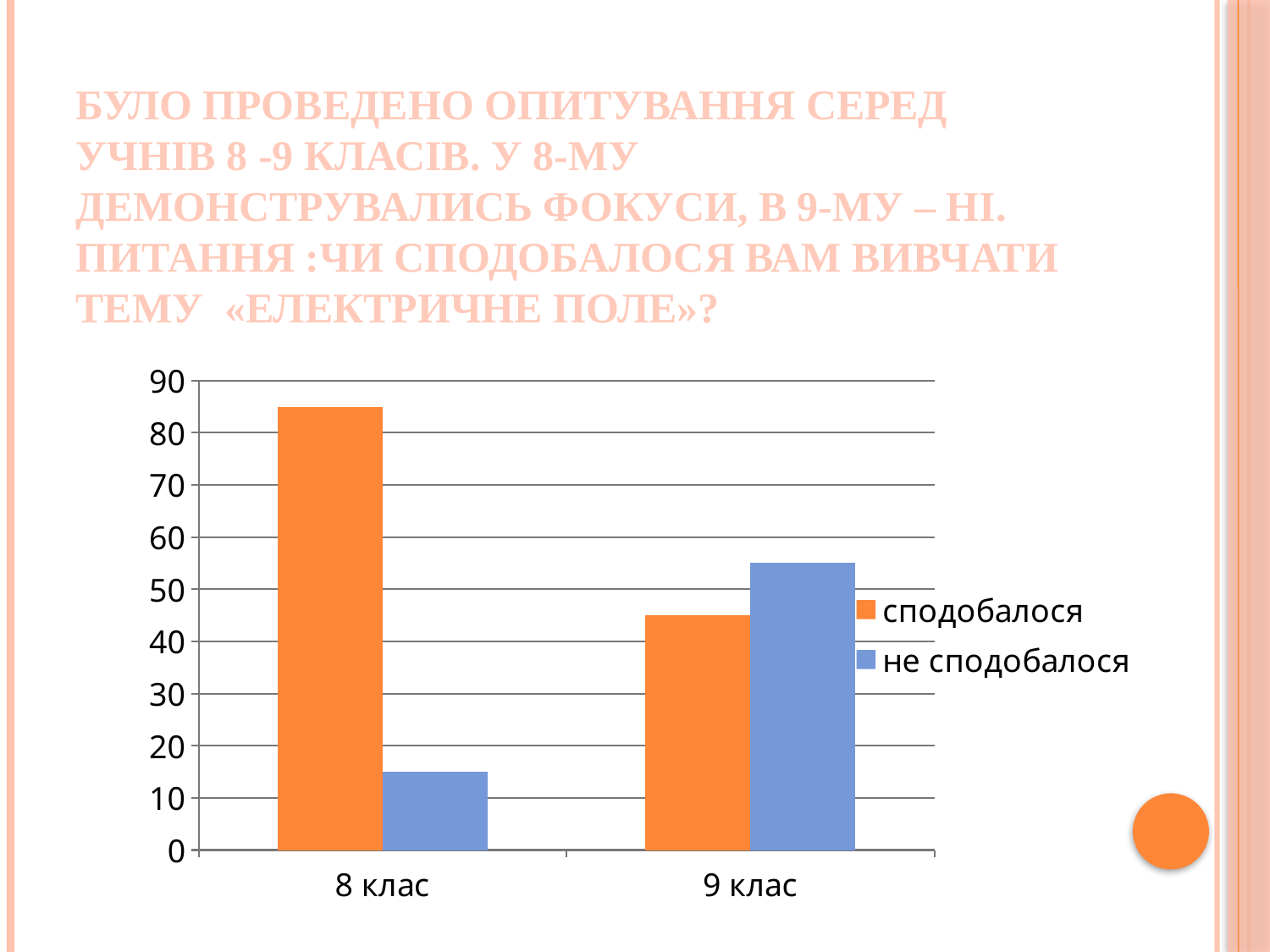
Which category has the highest value for сподобалося? 8 клас How many series does the chart's legend list? 2 Which series is shown in blue in the chart? не сподобалося Is the value for не сподобалося in 9 клас greater or less than 50? greater Which series is shown in orange in the chart? сподобалося Is the value for сподобалося in 8 клас greater or less than 80? greater Is the value for сподобалося in 9 клас greater or less than 50? less Which category has the lowest value for не сподобалося? 8 клас What kind of chart is shown on the slide? bar chart In 9 клас, which is larger: сподобалося or не сподобалося? не сподобалося How many categories are shown on the x axis of the chart? 2